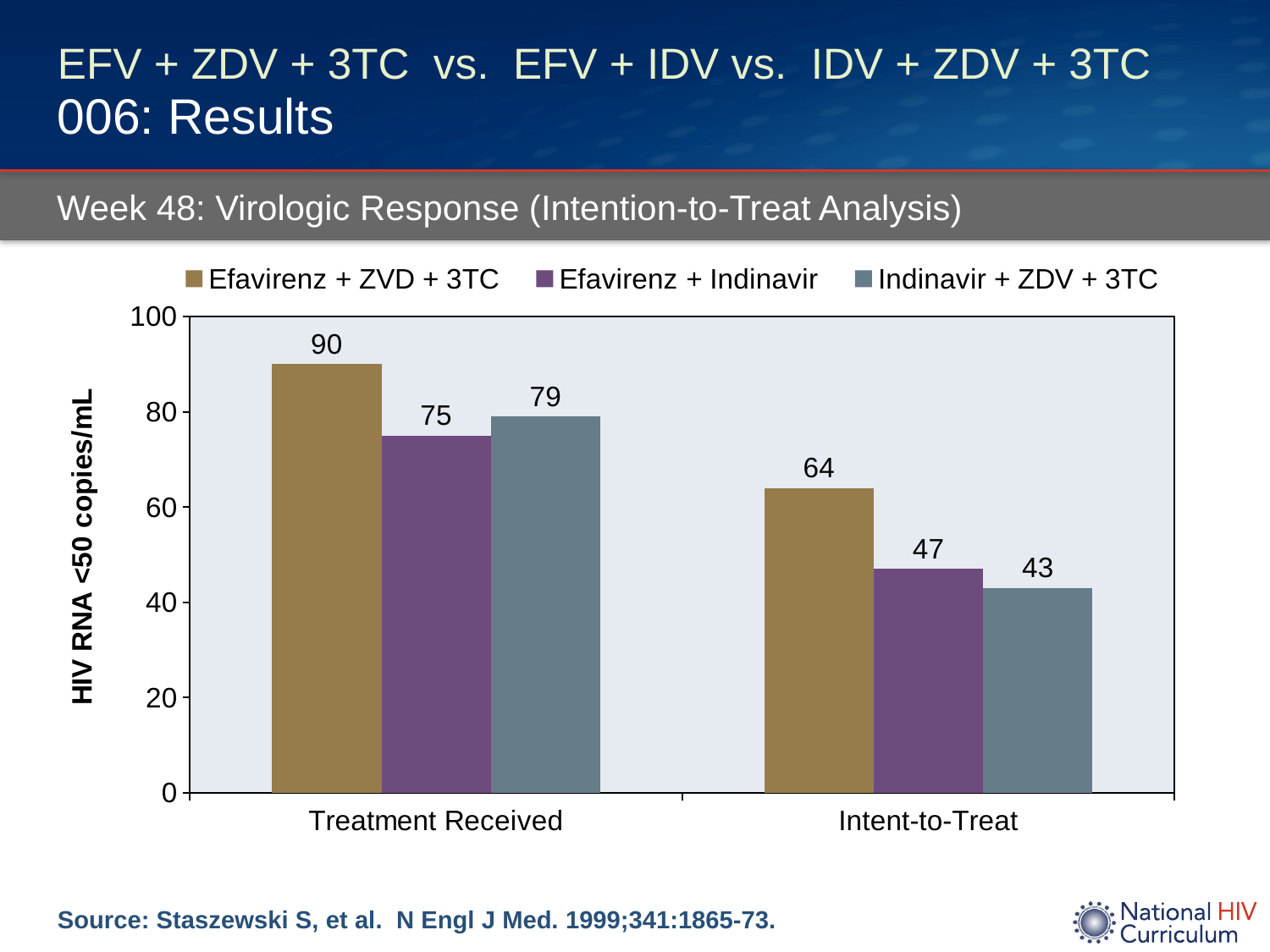
What is the value for Indinavir + ZDV + 3TC in the Intent-to-Treat group? 43 How many categories are shown on the x axis? 2 What kind of chart is shown on the slide? Bar chart What is the label of the y axis? HIV RNA <50 copies/mL How many series does the legend list? 3 In the Treatment Received group, which is larger: Efavirenz + Indinavir or Indinavir + ZDV + 3TC? Indinavir + ZDV + 3TC Which series has the highest value in the Treatment Received group? Efavirenz + ZVD + 3TC Is the value for Efavirenz + ZVD + 3TC in the Intent-to-Treat group greater or less than 60? greater What is the value for Efavirenz + Indinavir in the Intent-to-Treat group? 47 What is the value for Efavirenz + ZVD + 3TC in the Treatment Received group? 90 What is the difference between the Efavirenz + ZVD + 3TC values for Treatment Received and Intent-to-Treat? 26 Which series has the lowest value in the Intent-to-Treat group? Indinavir + ZDV + 3TC